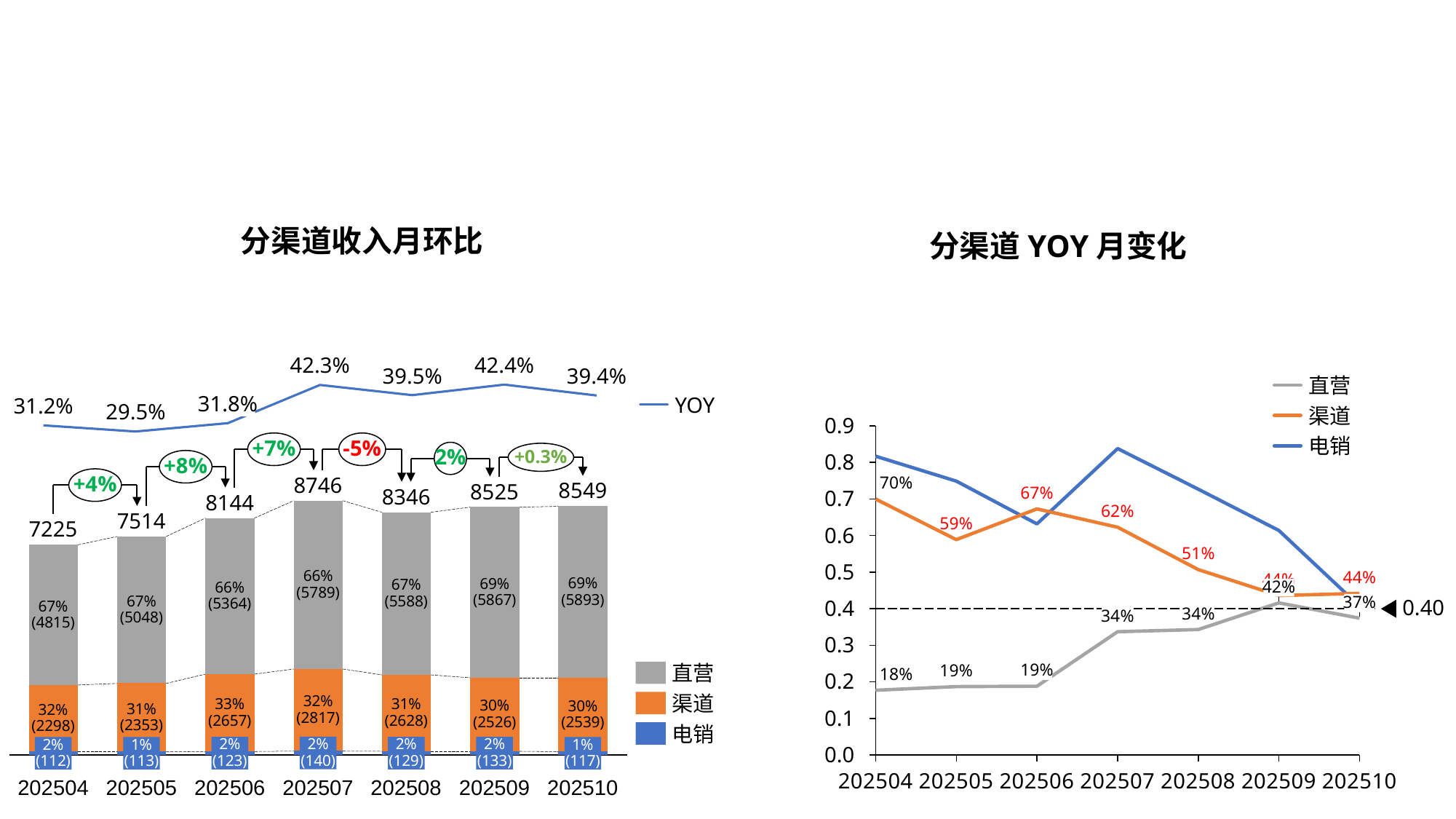
In the left chart (分渠道收入月环比), which month has the lowest total? 202504 In the left chart (分渠道收入月环比), what is the total value shown above the bar for 202507? 8746 What kind of chart is the left chart (分渠道收入月环比)? Stacked bar chart with a line In the left chart (分渠道收入月环比), what is the YOY value for 202506? 31.8% In the left chart (分渠道收入月环比), what is the difference between the totals for 202507 and 202508? 400 In the right chart (分渠道 YOY 月变化), what is the 渠道 value for 202508? 51% In the right chart (分渠道 YOY 月变化), how many series does the legend list? 3 In the left chart (分渠道收入月环比), how many months are shown on the x axis? 7 In the right chart (分渠道 YOY 月变化), is the 电销 value for 202507 greater or less than 0.8? greater In the left chart (分渠道收入月环比), what is the 直营 value for 202509? 5867 In the right chart (分渠道 YOY 月变化), which is larger at 202505, 渠道 or 直营? 渠道 In the left chart (分渠道收入月环比), which month has the highest total? 202507